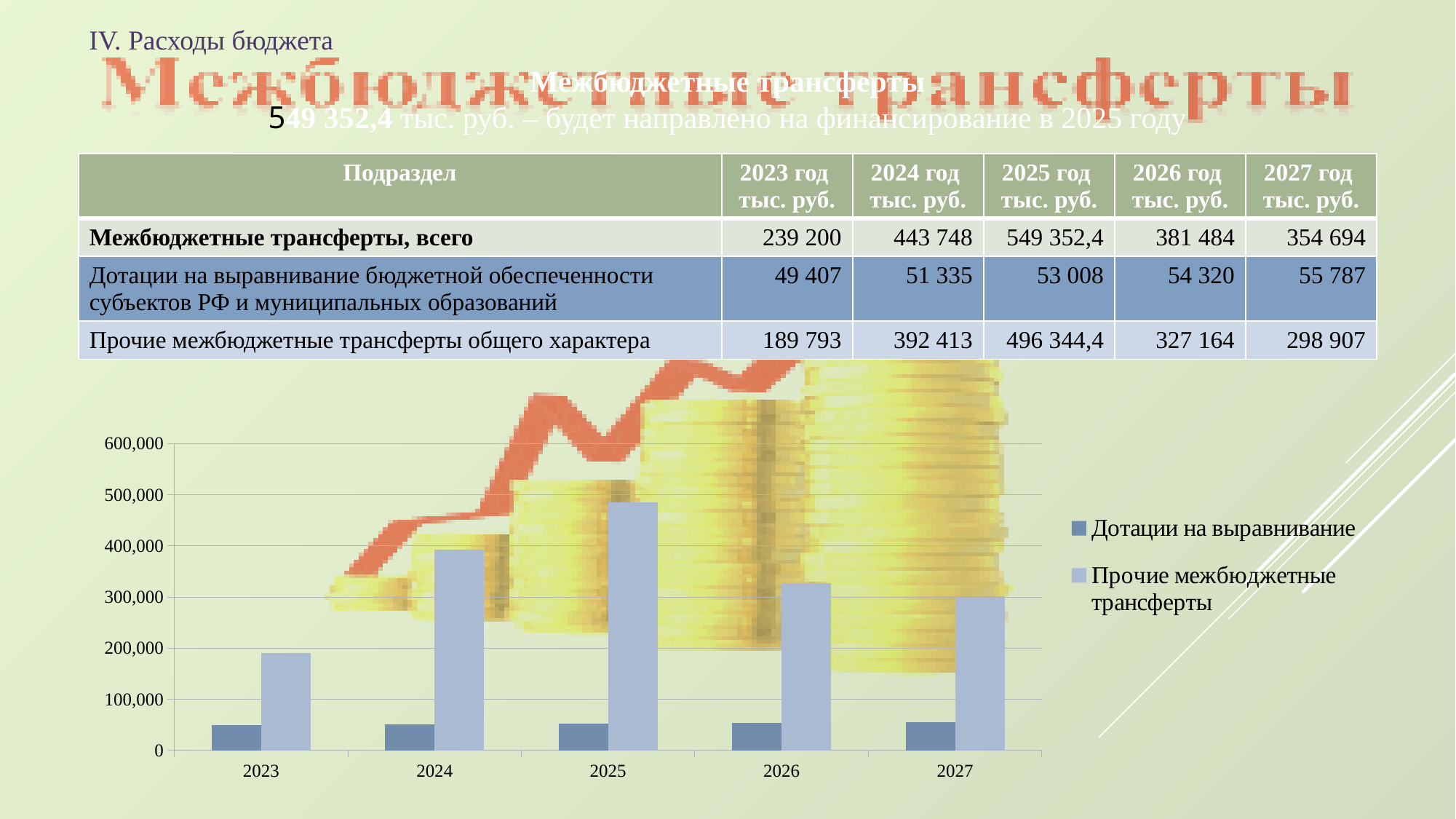
Does the value for Прочие межбюджетные трансферты rise or fall from 2025 to 2027? fall Is the value for Дотации на выравнивание in 2027 greater or less than 100,000? less In which year is the bar for Прочие межбюджетные трансферты the lowest? 2023 Which series is shown in the darker blue bars in the chart? Дотации на выравнивание How many years are shown on the x axis of the chart? 5 What kind of chart is shown on the slide? bar chart Which is larger in 2026: Дотации на выравнивание or Прочие межбюджетные трансферты? Прочие межбюджетные трансферты Is the value for Прочие межбюджетные трансферты in 2025 greater or less than 400,000? greater How many series does the chart legend list? 2 In which year is the bar for Прочие межбюджетные трансферты the highest? 2025 Does the value for Дотации на выравнивание rise or fall from 2023 to 2027? rise Is the value for Прочие межбюджетные трансферты in 2023 greater or less than 200,000? less